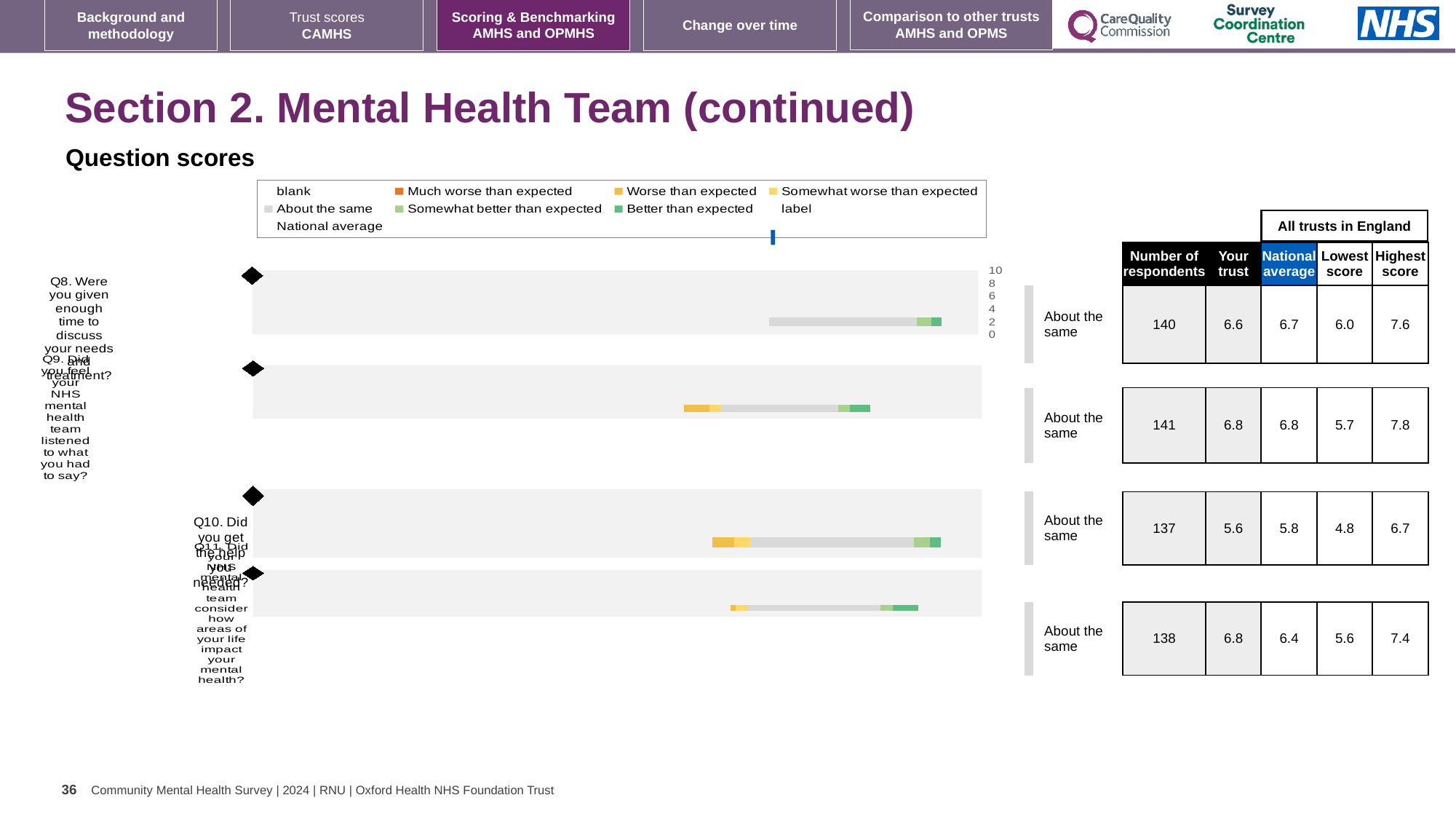
What colour does the legend use for 'Much worse than expected'? Orange How many questions (categories) are plotted in the question scores chart? 4 How many respondents answered Q11? 138 What is the highest score across all trusts in England for Q9? 7.8 For Q8, which is larger: the 'Your trust' score or the national average? National average Which question has the lowest 'Your trust' score? Q10 For Q10, what is the difference between the highest score and the lowest score across all trusts in England? 1.9 What is the 'Your trust' score for Q8 (Were you given enough time to discuss your needs and treatment?)? 6.6 What kind of chart is used to show the question scores on this slide? bar chart What is the national average score for Q10 (Did you get the help you needed?)? 5.8 Which question has the highest number of respondents? Q9 What benchmark category is shown for Q9 (Did you feel your NHS mental health team listened to what you had to say?)? About the same